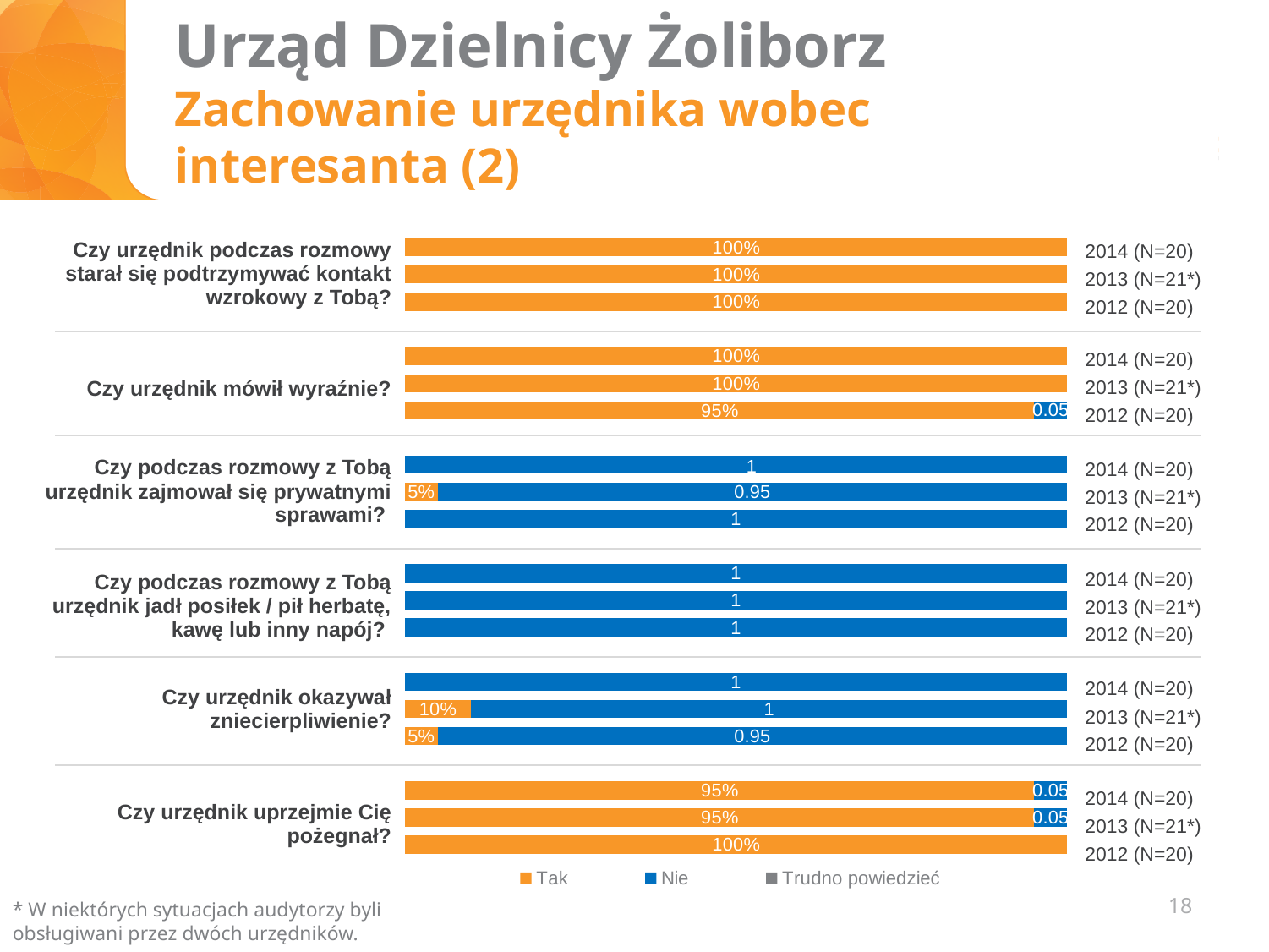
What kind of chart is shown on the slide? bar chart What is the 'Nie' value for 'Czy podczas rozmowy z Tobą urzędnik zajmował się prywatnymi sprawami?' in 2013 (N=21*)? 0.95 What is the 'Tak' value for 'Czy urzędnik okazywał zniecierpliwienie?' in 2012 (N=20)? 5% For 'Czy urzędnik mówił wyraźnie?', which year has the larger 'Tak' value, 2014 or 2012? 2014 What is the 'Tak' value for 'Czy urzędnik mówił wyraźnie?' in 2012 (N=20)? 95% What is the 'Tak' value for 'Czy urzędnik okazywał zniecierpliwienie?' in 2013 (N=21*)? 10% What is the 'Tak' value for 'Czy urzędnik uprzejmie Cię pożegnał?' in 2014 (N=20)? 95% What are the entries in the chart legend? Tak, Nie, Trudno powiedzieć What is the 'Tak' value for 'Czy urzędnik uprzejmie Cię pożegnał?' in 2012 (N=20)? 100% What is the 'Nie' value for 'Czy podczas rozmowy z Tobą urzędnik jadł posiłek / pił herbatę, kawę lub inny napój?' in 2014 (N=20)? 1 How many survey questions are shown on the chart? 6 How many series does the legend list? 3